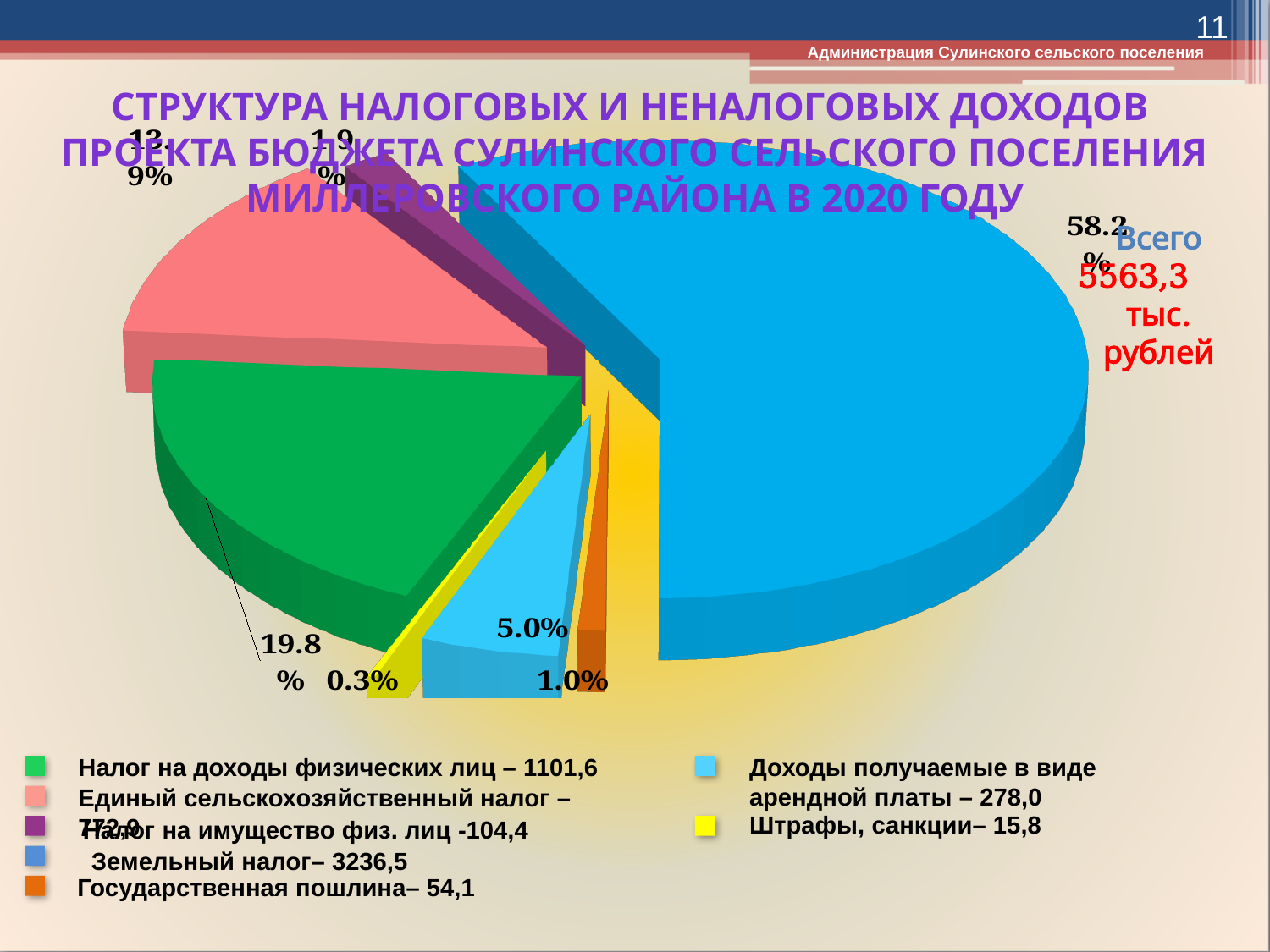
Which category has the largest slice of the pie? Земельный налог What is the difference between the values for Земельный налог and Налог на доходы физических лиц? 2134,9 What share of the pie does Земельный налог represent? 58.2% What total amount (Всего) is shown next to the pie chart? 5563,3 тыс. рублей What share of the pie does Налог на доходы физических лиц represent? 19.8% What kind of chart is shown on the slide? Pie chart What value is given in the legend for Земельный налог? 3236,5 Which category has the smallest slice of the pie? Штрафы, санкции Which is larger: Доходы получаемые в виде арендной платы or Государственная пошлина? Доходы получаемые в виде арендной платы What value is given in the legend for Налог на доходы физических лиц? 1101,6 How many categories does the legend of the pie chart list? 7 What value is given in the legend for Штрафы, санкции? 15,8